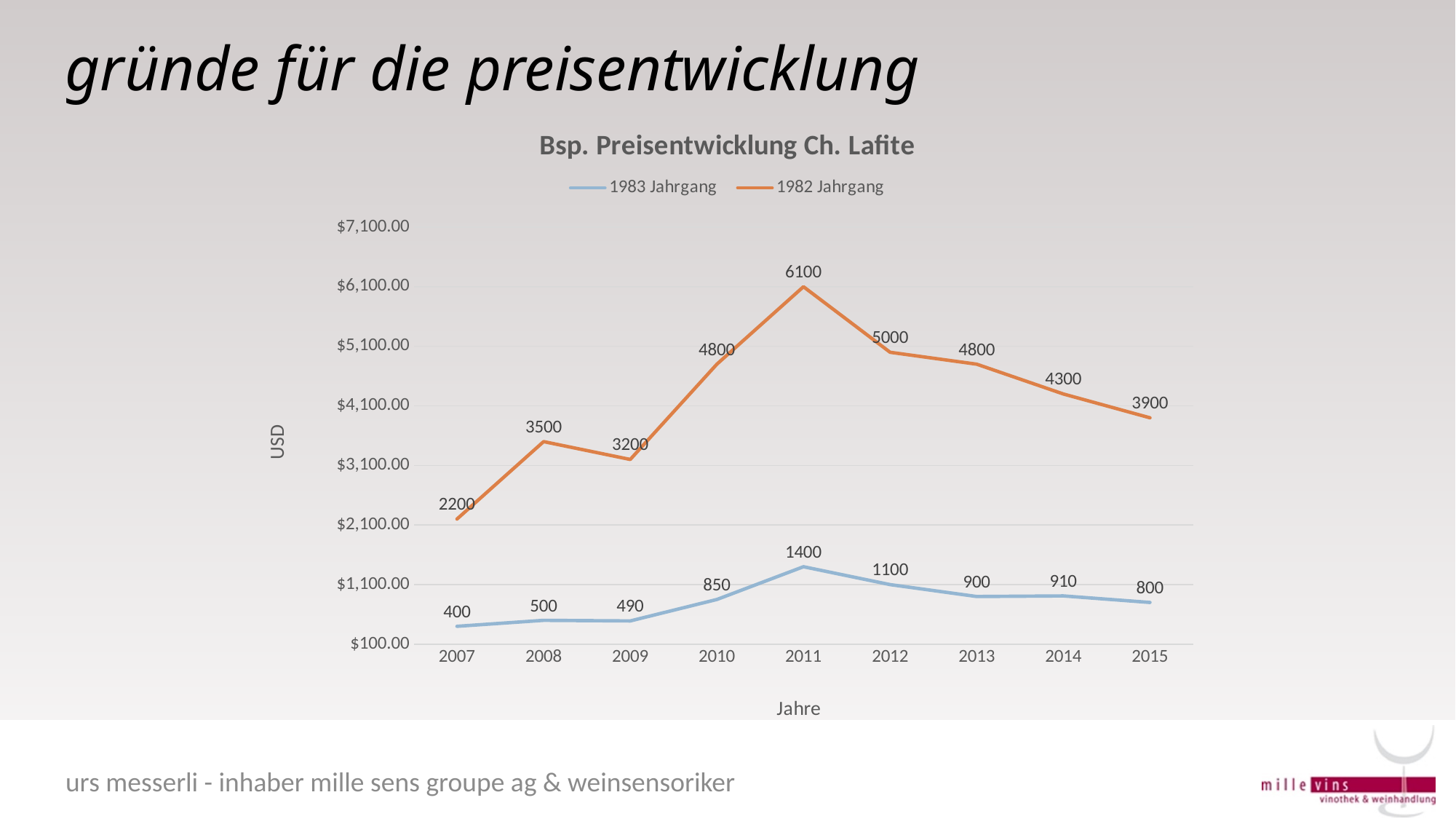
What is the title of the chart? Bsp. Preisentwicklung Ch. Lafite Which series has the larger value in 2010, 1983 Jahrgang or 1982 Jahrgang? 1982 Jahrgang What is the value for the 1983 Jahrgang series in 2009? 490 How many years are shown on the x axis? 9 Does the 1982 Jahrgang series rise or fall from 2011 to 2015? fall What is the value for the 1982 Jahrgang series in 2011? 6100 In which year does the 1982 Jahrgang series reach its highest value? 2011 What is the difference between the 1982 Jahrgang and 1983 Jahrgang values in 2015? 3100 Is the value for the 1982 Jahrgang series in 2008 greater or less than $3,100.00? greater In which year is the 1983 Jahrgang series at its lowest value? 2007 How many series does the legend list? 2 What kind of chart is shown on the slide? line chart